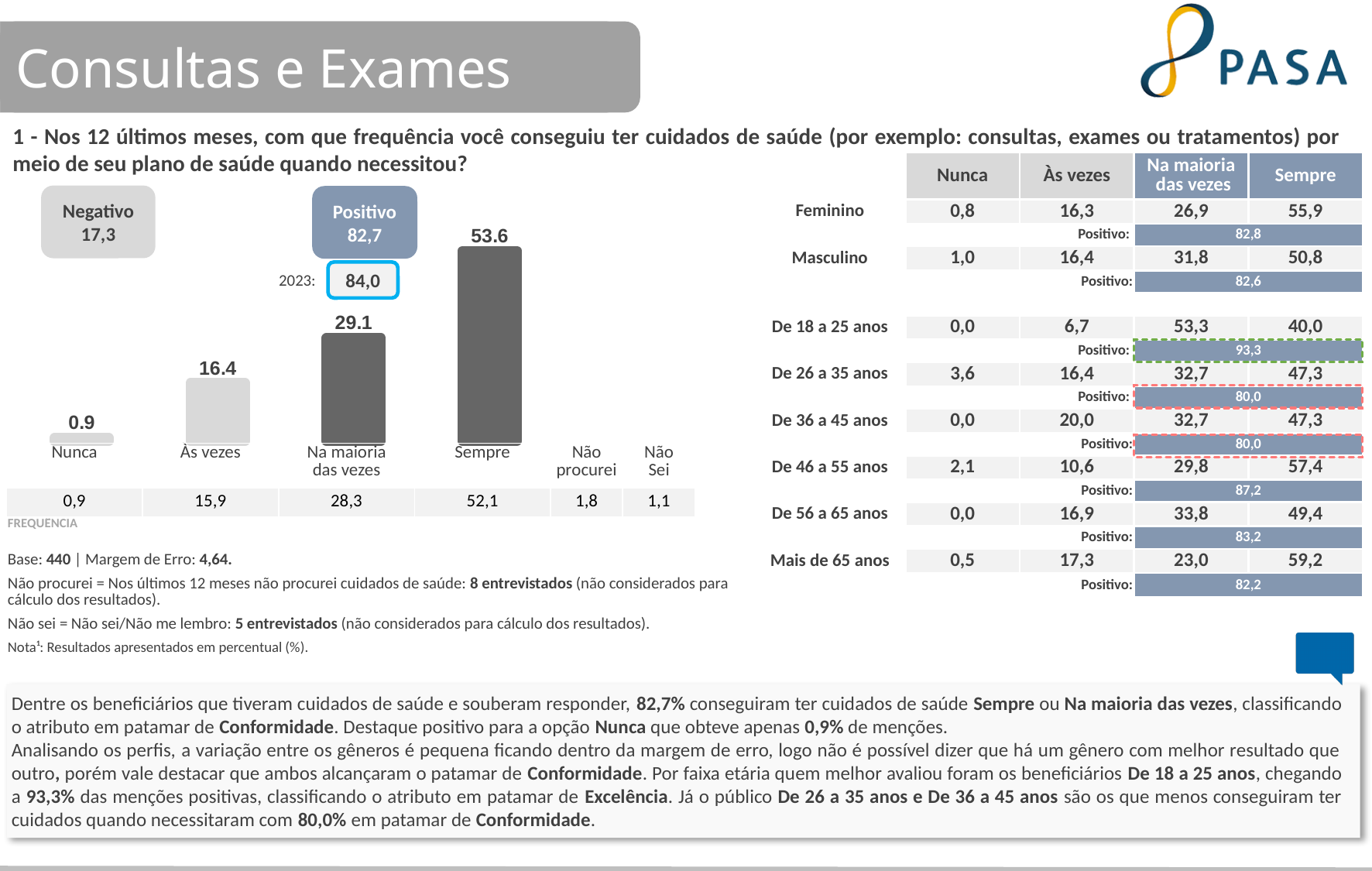
What is the value of the 'Na maioria das vezes' bar in the chart? 29.1 What is the value of the 'Nunca' bar in the chart? 0.9 What is the value of the 'Às vezes' bar in the chart? 16.4 How many bars are plotted in the chart? 4 Do the bar values rise or fall from 'Nunca' to 'Sempre' along the x axis? Rise What is the value of the 'Sempre' bar in the chart? 53.6 What is the difference between the 'Sempre' and 'Na maioria das vezes' bars? 24.5 What is the difference between the 'Às vezes' and 'Nunca' bars? 15.5 Which category has the lowest bar in the chart? Nunca Which category has the highest bar in the chart? Sempre Which is larger in the chart, 'Às vezes' or 'Na maioria das vezes'? Na maioria das vezes What type of chart is shown on the slide? Bar chart